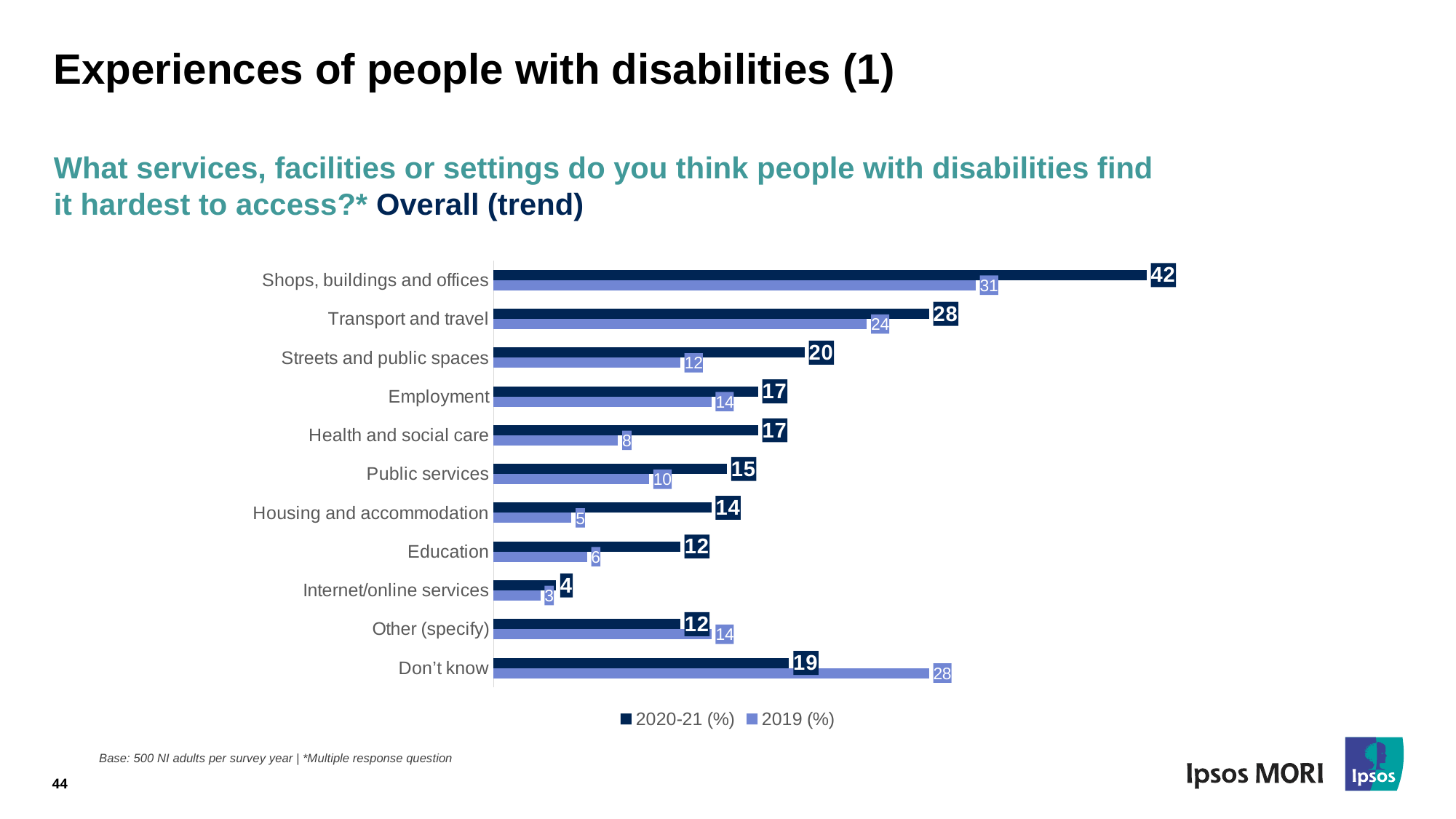
For Other (specify), which is larger: the 2020-21 (%) value or the 2019 (%) value? 2019 (%) What is the 2019 (%) value for Health and social care? 8 What is the difference between the 2020-21 (%) and 2019 (%) values for Streets and public spaces? 8 How many series does the legend list? 2 What is the 2020-21 (%) value for Shops, buildings and offices? 42 Which category has the highest 2020-21 (%) value? Shops, buildings and offices Which series is shown in the lighter blue colour? 2019 (%) How many categories are shown on the chart? 11 For Don't know, which is larger: the 2020-21 (%) value or the 2019 (%) value? 2019 (%) What kind of chart is shown on the slide? Bar chart What is the 2019 (%) value for Transport and travel? 24 Which category has the lowest 2019 (%) value? Internet/online services